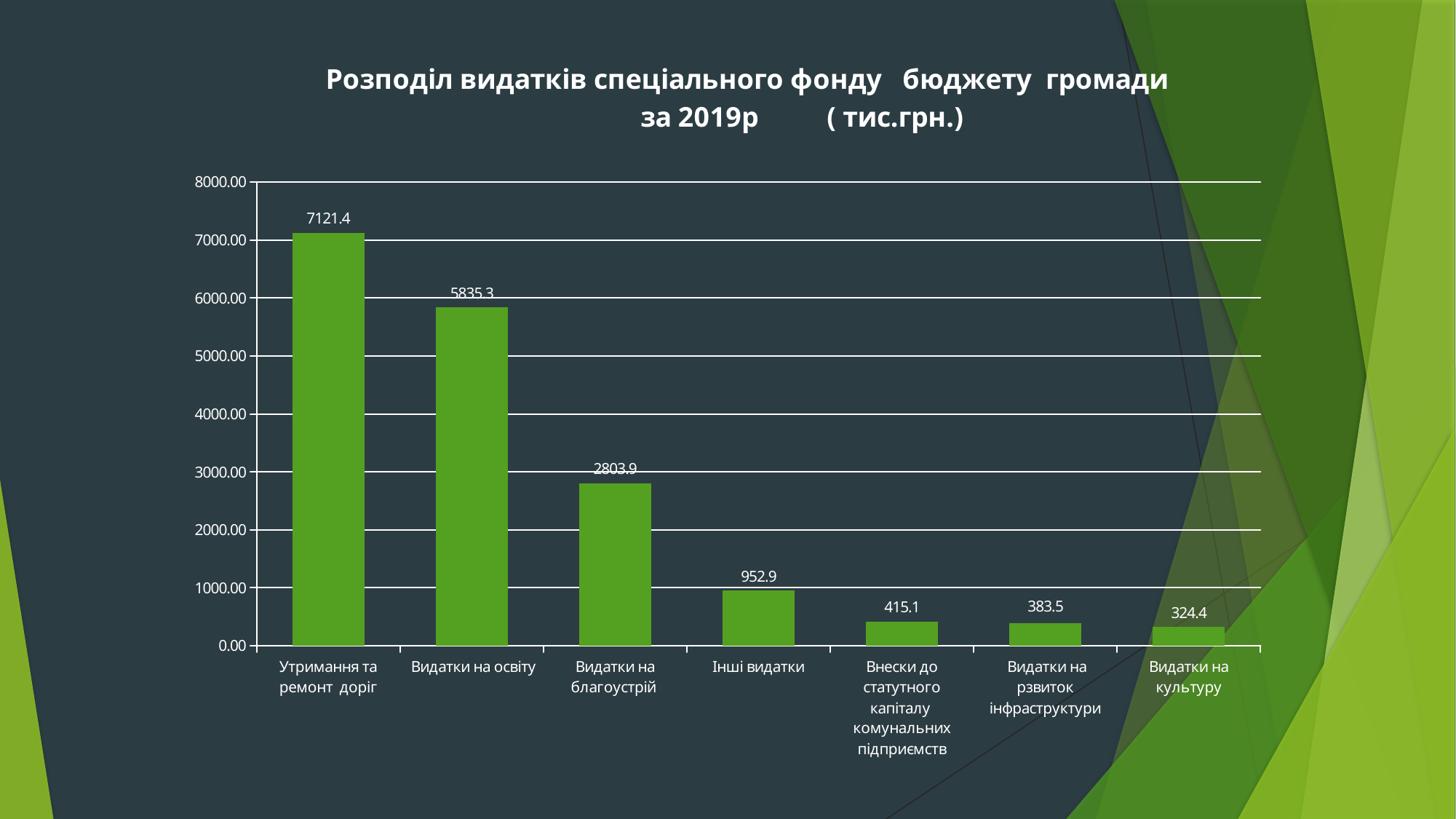
What is the difference between the values for "Утримання та ремонт доріг" and "Видатки на освіту"? 1286.1 How many categories are shown on the x axis? 7 What kind of chart is shown on the slide? Bar chart Which category has the highest value? Утримання та ремонт доріг What is the difference between the values for "Внески до статутного капіталу комунальних підприємств" and "Видатки на рзвиток інфраструктури"? 31.6 Which category has the lowest value? Видатки на культуру Which is larger: the value for "Інші видатки" or the value for "Видатки на благоустрій"? Видатки на благоустрій Do the values rise or fall from left to right along the x axis? Fall What is the value for "Видатки на благоустрій"? 2803.9 What is the value for "Видатки на культуру"? 324.4 What is the value for "Утримання та ремонт доріг"? 7121.4 What is the value for "Видатки на освіту"? 5835.3